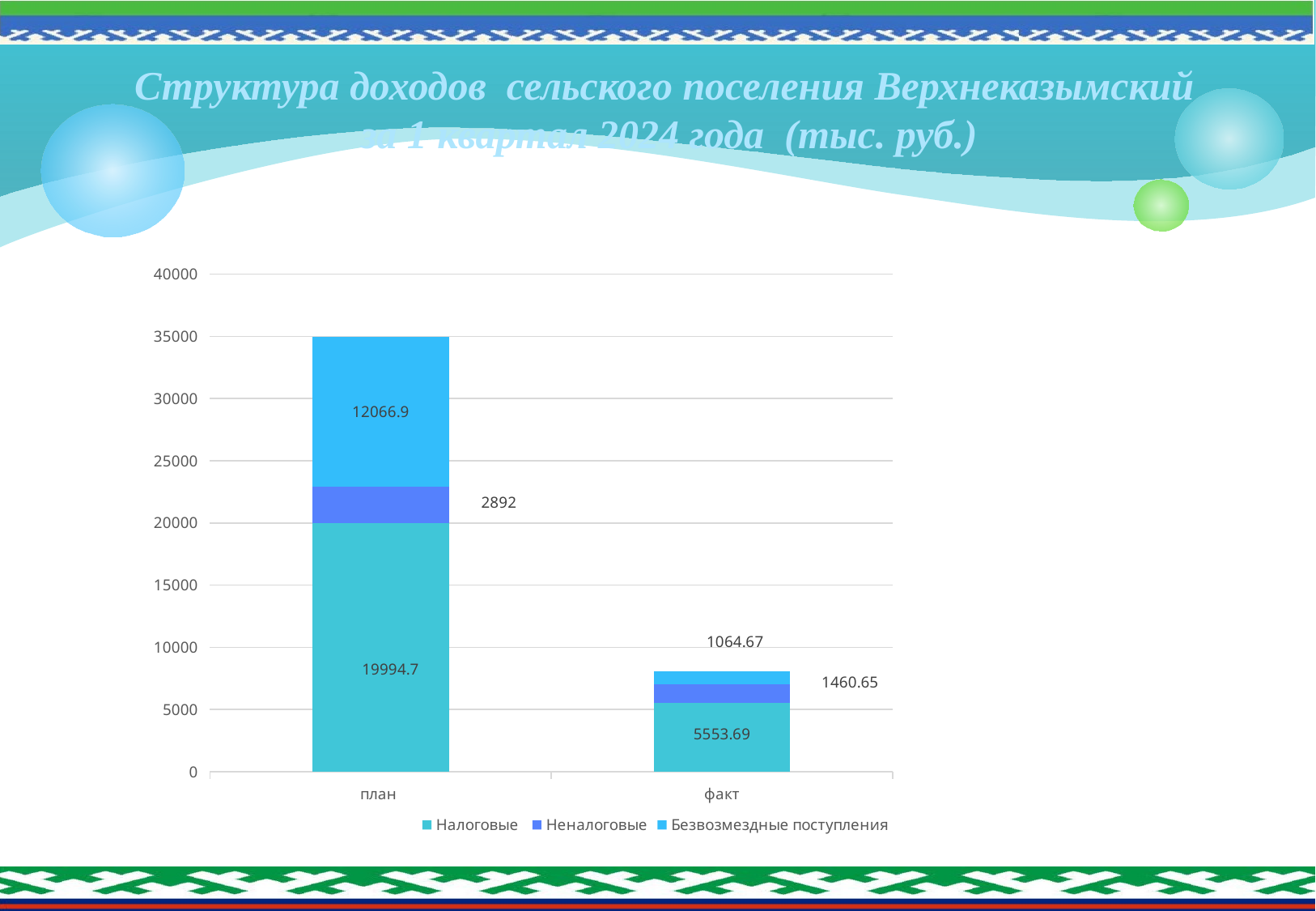
What is the value of Безвозмездные поступления for план? 12066.9 What is the value of Налоговые for факт? 5553.69 How many series does the legend list? 3 What kind of chart is shown on the slide? Stacked bar chart What is the difference between Налоговые for план and Налоговые for факт? 14441.01 What is the total of the stacked bar for план? 34953.6 What is the value of Налоговые for план? 19994.7 Which category has the higher total, план or факт? план What is the value of Неналоговые for план? 2892 Is the total of the факт bar greater or less than 10000? less How many categories are shown on the x axis? 2 What is the value of Безвозмездные поступления for факт? 1064.67